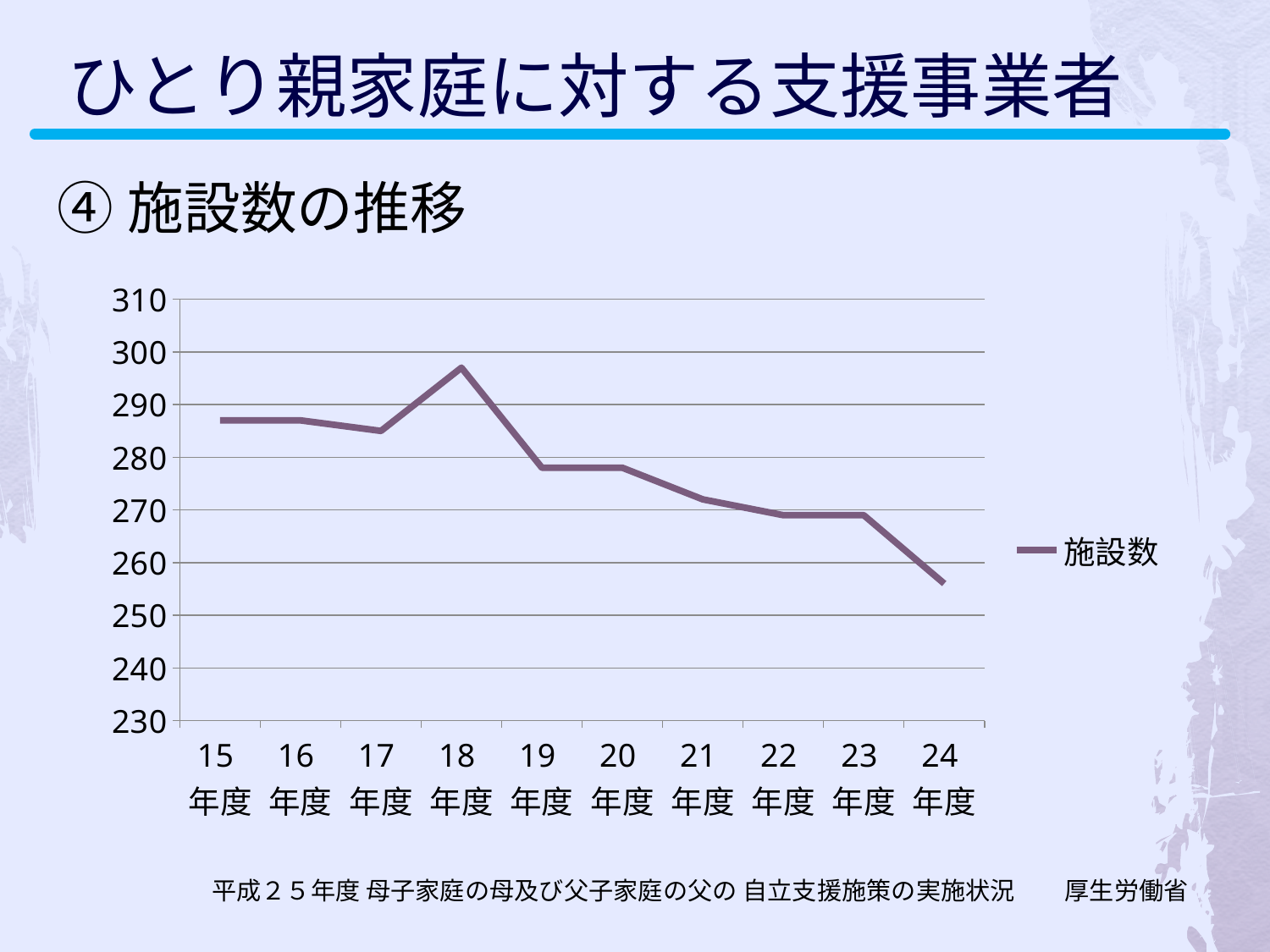
Overall, do the values rise or fall from 15年度 to 24年度? fall What kind of chart is shown on the slide? line chart What is the name of the series shown in the legend? 施設数 Is the value for 15年度 greater or less than 280? greater Is the value for 24年度 greater or less than 260? less In which fiscal year is the number of facilities (施設数) highest? 18年度 In which fiscal year is the number of facilities (施設数) lowest? 24年度 Is the value for 18年度 greater or less than 290? greater How many fiscal years (data points) are plotted on the x axis? 10 Which is larger, the value for 15年度 or the value for 24年度? 15年度 How many series does the legend list? 1